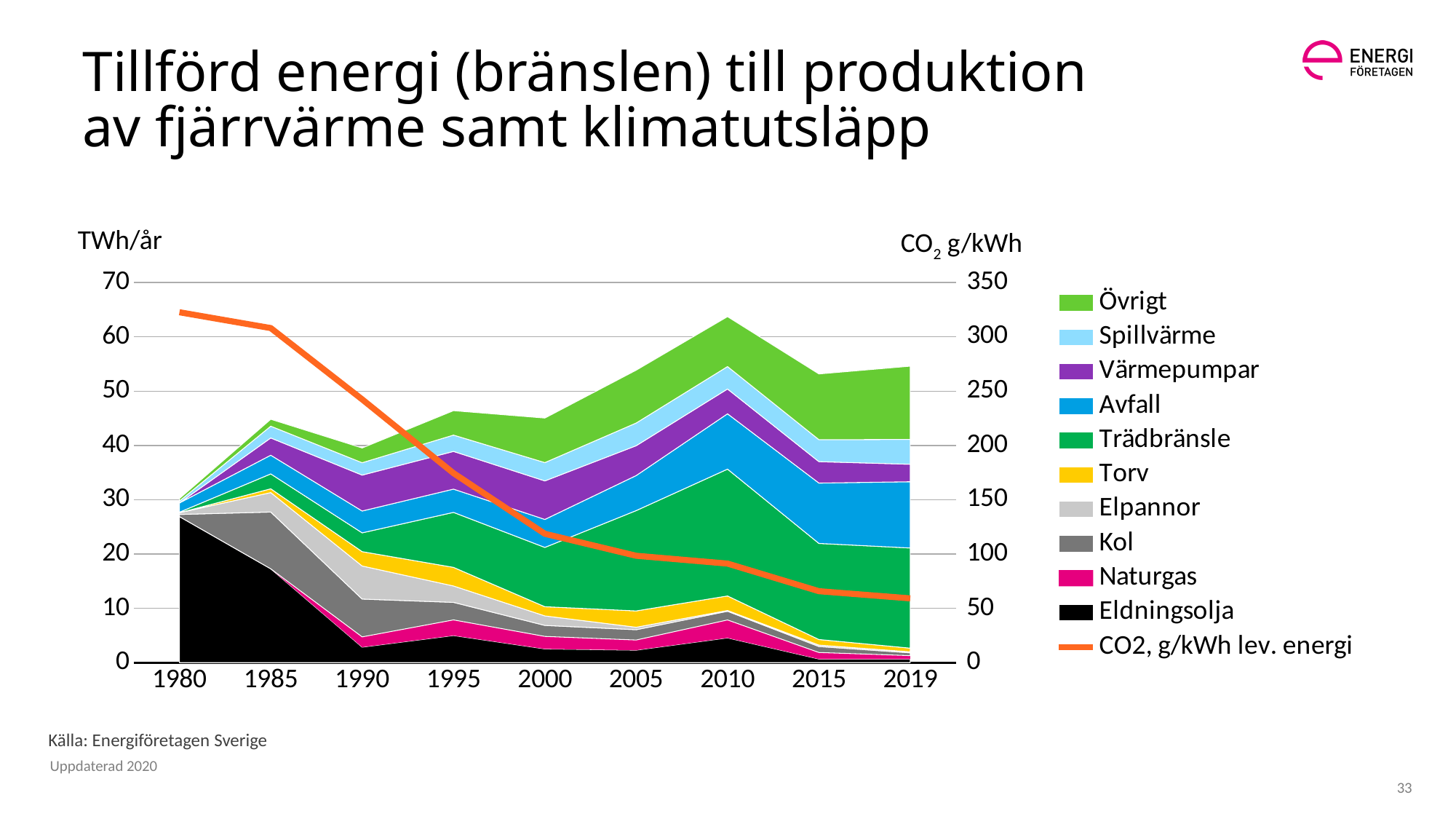
Is the CO2, g/kWh lev. energi value for 2019 greater or less than 100? less What kind of chart is shown on the slide? Stacked area chart with a line In which year is the total supplied energy (top of the stacked area) highest? 2010 What unit is shown on the left vertical axis of the chart? TWh/år How many years are shown along the x axis of the chart? 9 Is the total supplied energy (top of the stacked area) for 2010 greater or less than 60 TWh/år? greater Is the Eldningsolja value for 1980 greater or less than 20 TWh/år? greater In which year is the CO2, g/kWh lev. energi value lowest? 2019 Which year has the larger total supplied energy, 2010 or 2019? 2010 Does the CO2, g/kWh lev. energi line rise or fall from 1980 to 2019? Fall How many entries does the chart's legend list? 11